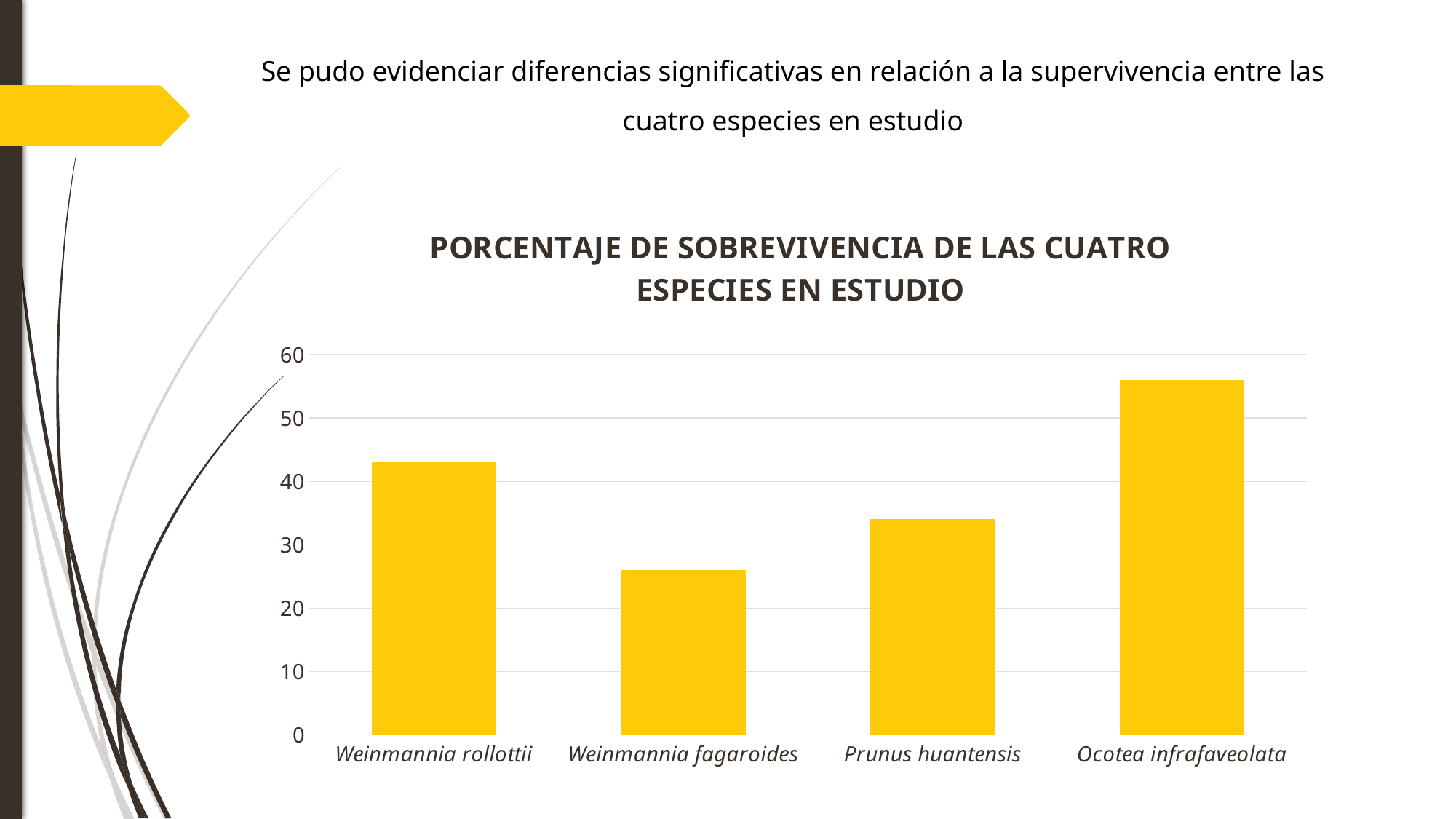
Which has a higher survival percentage, Weinmannia fagaroides or Prunus huantensis? Prunus huantensis Is the value for Weinmannia rollottii greater or less than 40? greater Is the value for Weinmannia fagaroides greater or less than 30? less What is the title of the chart? PORCENTAJE DE SOBREVIVENCIA DE LAS CUATRO ESPECIES EN ESTUDIO What is the maximum value shown on the vertical axis? 60 Is the value for Prunus huantensis greater or less than 40? less Which species has the highest survival percentage? Ocotea infrafaveolata What kind of chart is shown on the slide? bar chart How many species (categories) are plotted in the chart? 4 Which species has the lowest survival percentage? Weinmannia fagaroides Which has a higher survival percentage, Weinmannia rollottii or Prunus huantensis? Weinmannia rollottii